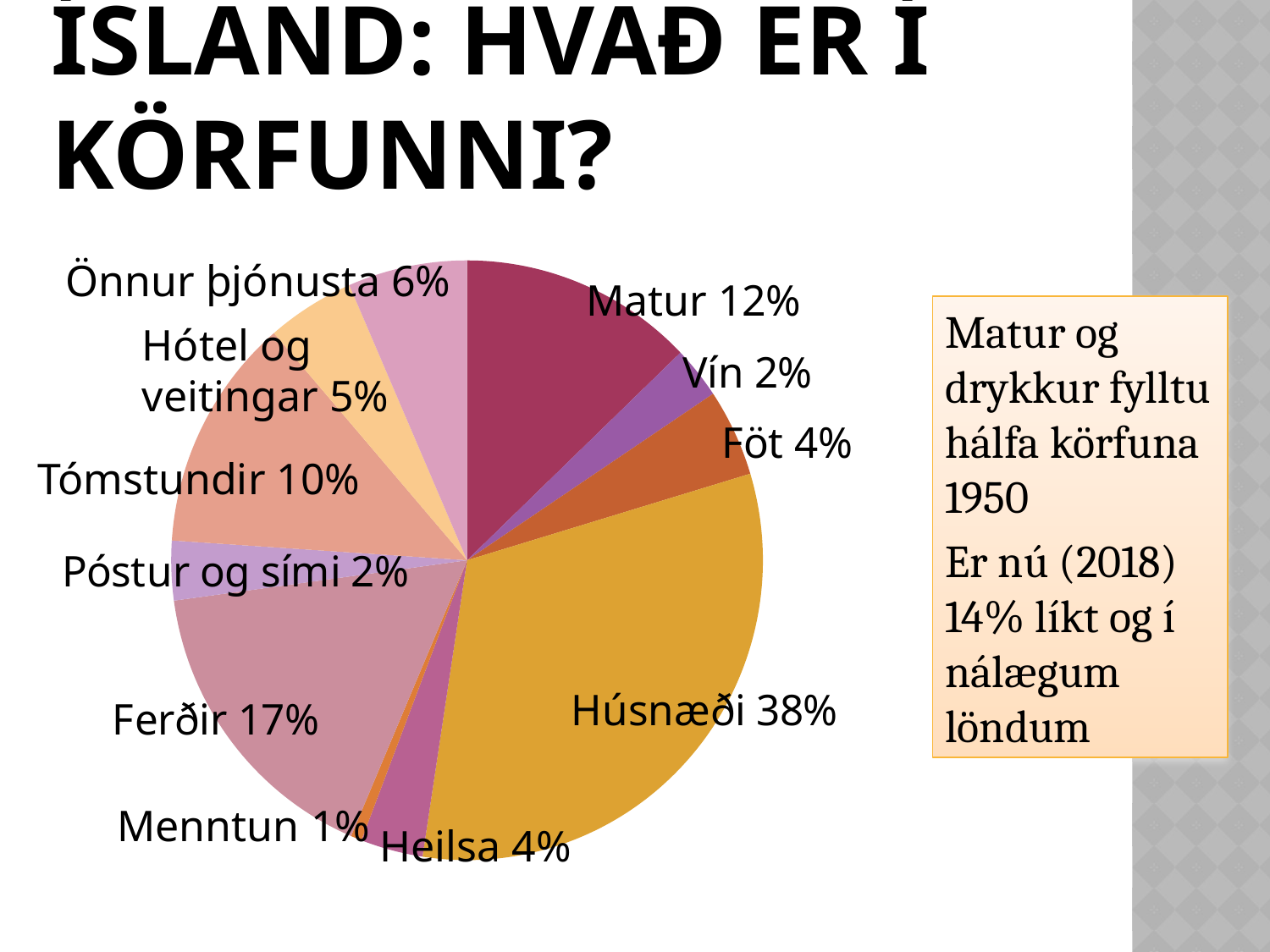
What is the difference between the shares of Húsnæði and Ferðir? 21% What is the value shown for Ferðir? 17% Which category has the largest slice of the pie? Húsnæði What is the value shown for Tómstundir? 10% How many categories are shown in the pie chart? 11 What kind of chart is shown on the slide? pie chart What is the difference between the shares of Önnur þjónusta and Vín? 4% Which is larger, the share for Matur or the share for Tómstundir? Matur Which category has the smallest slice of the pie? Menntun What share of the pie does Húsnæði have? 38% What is the title of the slide containing the pie chart? ÍSLAND: HVAÐ ER Í KÖRFUNNI? What is the value shown for Hótel og veitingar? 5%